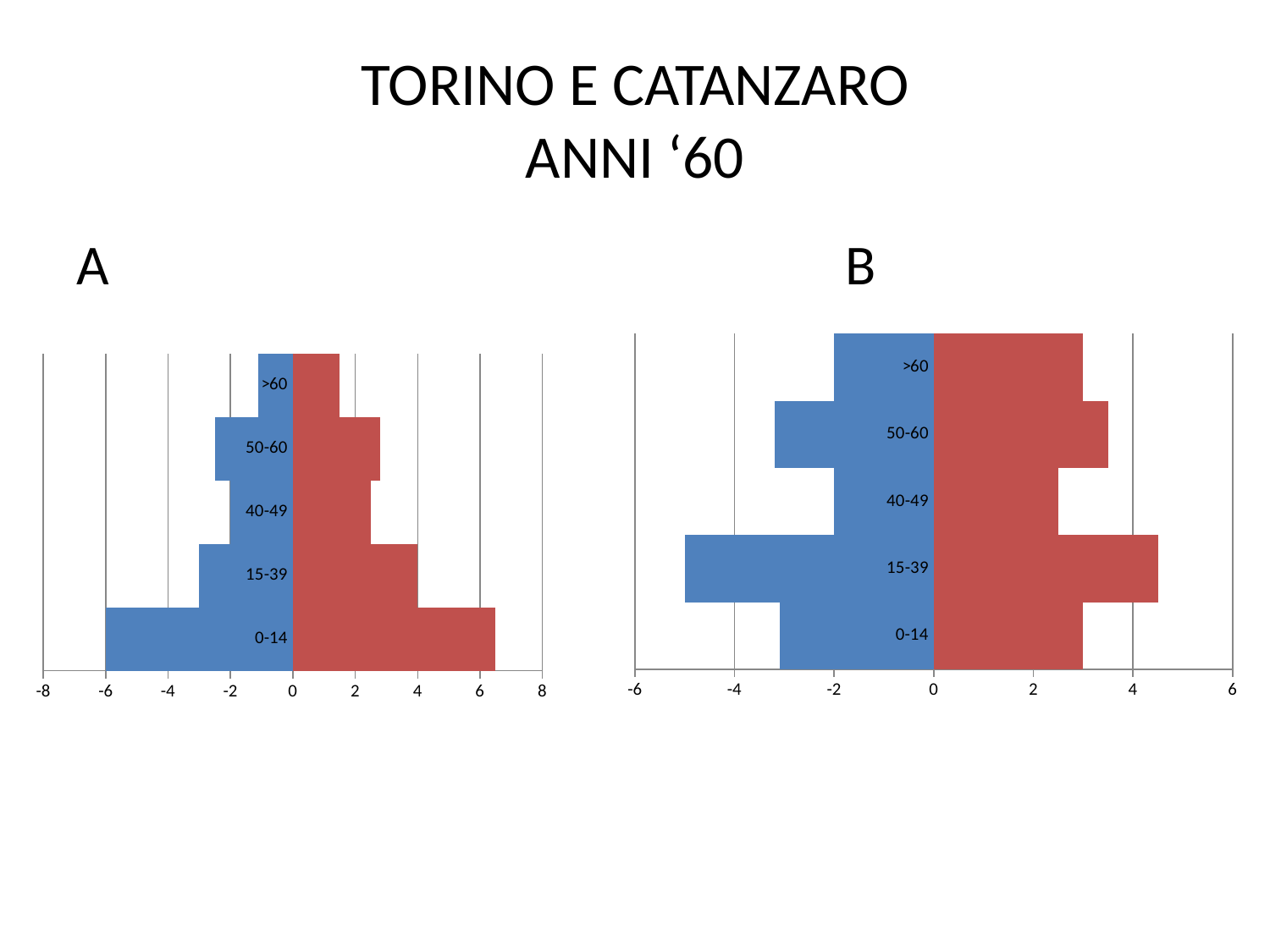
In chart B, is the value of the red bar for 40-49 greater or less than 4? less How many age groups are shown in chart B? 5 In chart A, which age group has the shortest blue bar? >60 In chart A, which red bar is longer: 15-39 or 50-60? 15-39 In chart A, is the value of the red bar for 0-14 greater or less than 6? greater In chart A, is the value of the red bar for 15-39 greater or less than 2? greater In chart A, which age group has the shortest red bar? >60 In chart A, which age group has the longest red bar? 0-14 In chart B, which age group has the blue bar extending furthest to the left? 15-39 In chart B, which age group has the longest red bar? 15-39 What kind of chart is chart A? bar chart